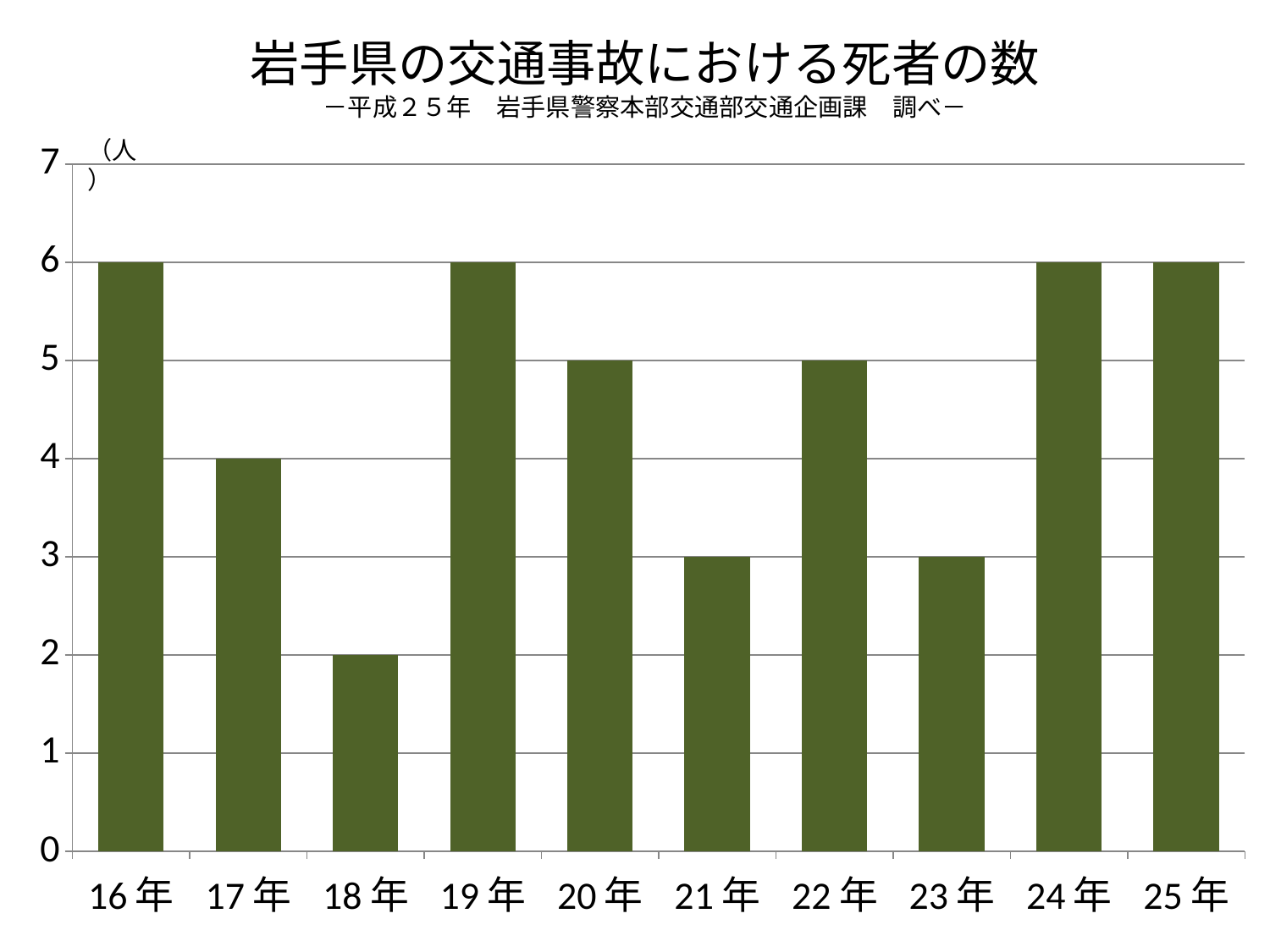
What is the value for 23年? 3 What is the value for 17年? 4 What is the value for 18年? 2 What is the difference between the values for 16年 and 18年? 4 Which year has the lowest value? 18年 What is the difference between the values for 22年 and 21年? 2 Which is larger, the value for 19年 or the value for 20年? 19年 How many years are shown on the x axis? 10 What is the title of the chart? 岩手県の交通事故における死者の数 What is the value for 20年? 5 What kind of chart is this? bar chart Is the value for 24年 greater or less than 5? greater